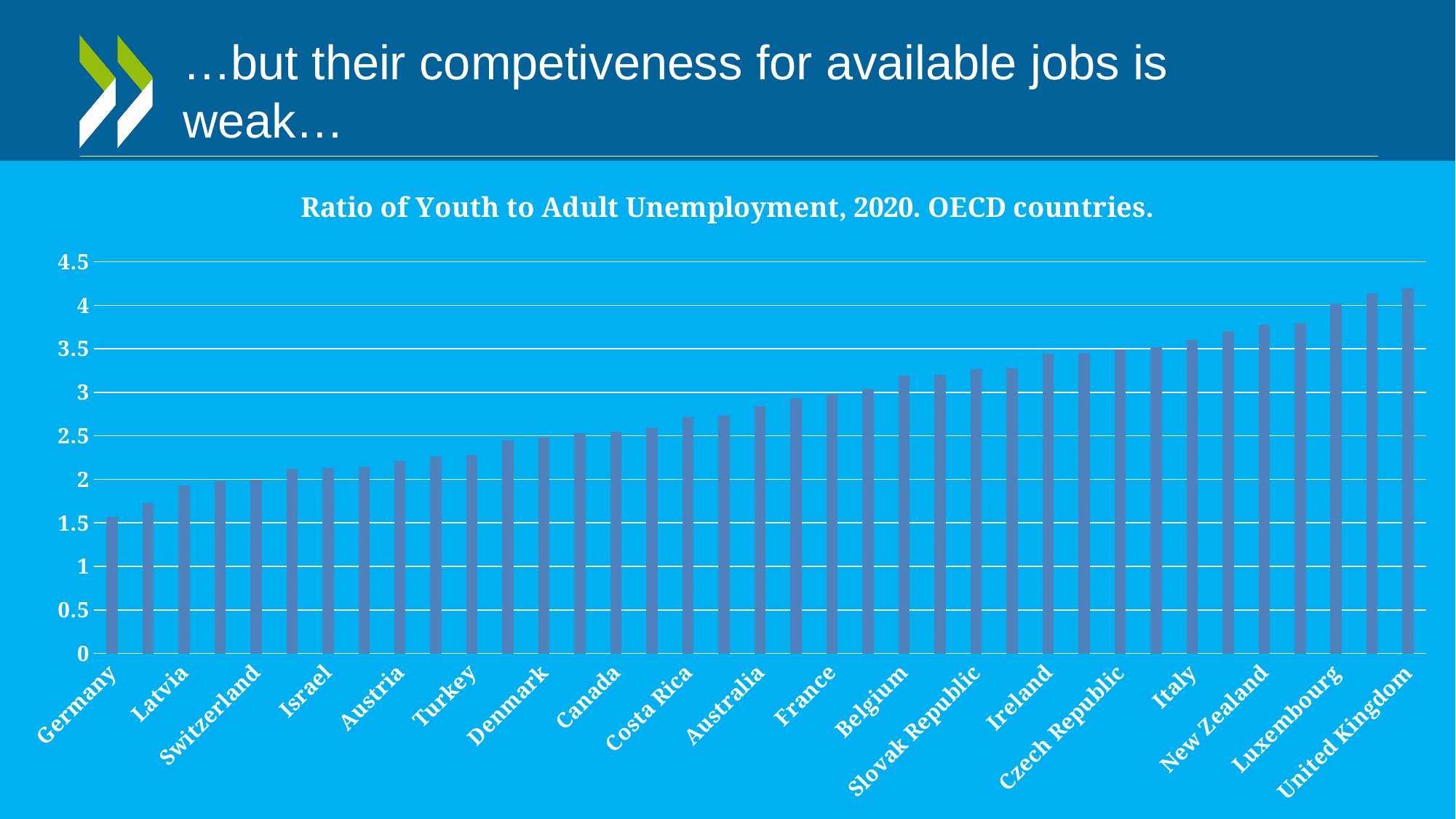
Which has the larger value, Germany or the United Kingdom? United Kingdom Do the values rise or fall moving from left to right along the x axis? rise What is the highest value shown on the vertical axis? 4.5 Is the value for the United Kingdom greater or less than 4? greater What kind of chart is shown on the slide? bar chart Which country has the highest ratio of youth to adult unemployment in the chart? United Kingdom Is the value for the United Kingdom greater or less than 3.5? greater Which country has the lowest ratio of youth to adult unemployment in the chart? Germany Is the value for Germany greater or less than 2? less Which has the larger value, Germany or Latvia? Latvia What is the title of the chart? Ratio of Youth to Adult Unemployment, 2020. OECD countries.